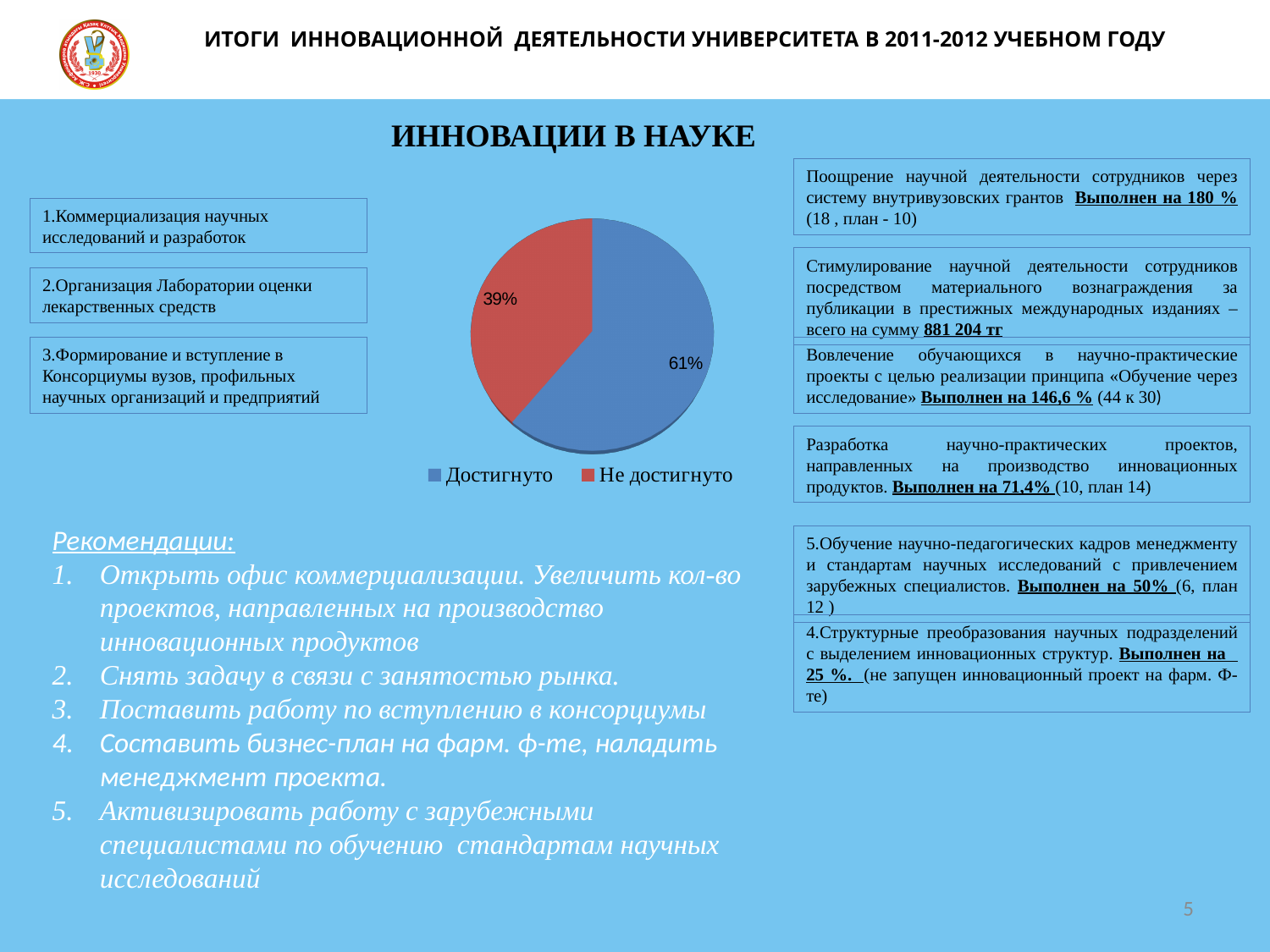
How many slices does the pie chart have? 2 What share of the pie does "Достигнуто" represent? 61% What kind of chart is shown on the slide? pie chart What colour is the "Достигнуто" slice in the pie chart? blue How many entries does the legend of the pie chart list? 2 Which is larger in the pie chart: "Достигнуто" or "Не достигнуто"? Достигнуто Which slice of the pie chart is the smallest? Не достигнуто What is the difference in percentage points between the "Достигнуто" and "Не достигнуто" slices? 22 Is the share for "Достигнуто" greater or less than 50%? greater What share of the pie does "Не достигнуто" represent? 39% What colour is the "Не достигнуто" slice in the pie chart? red Which slice of the pie chart is the largest? Достигнуто